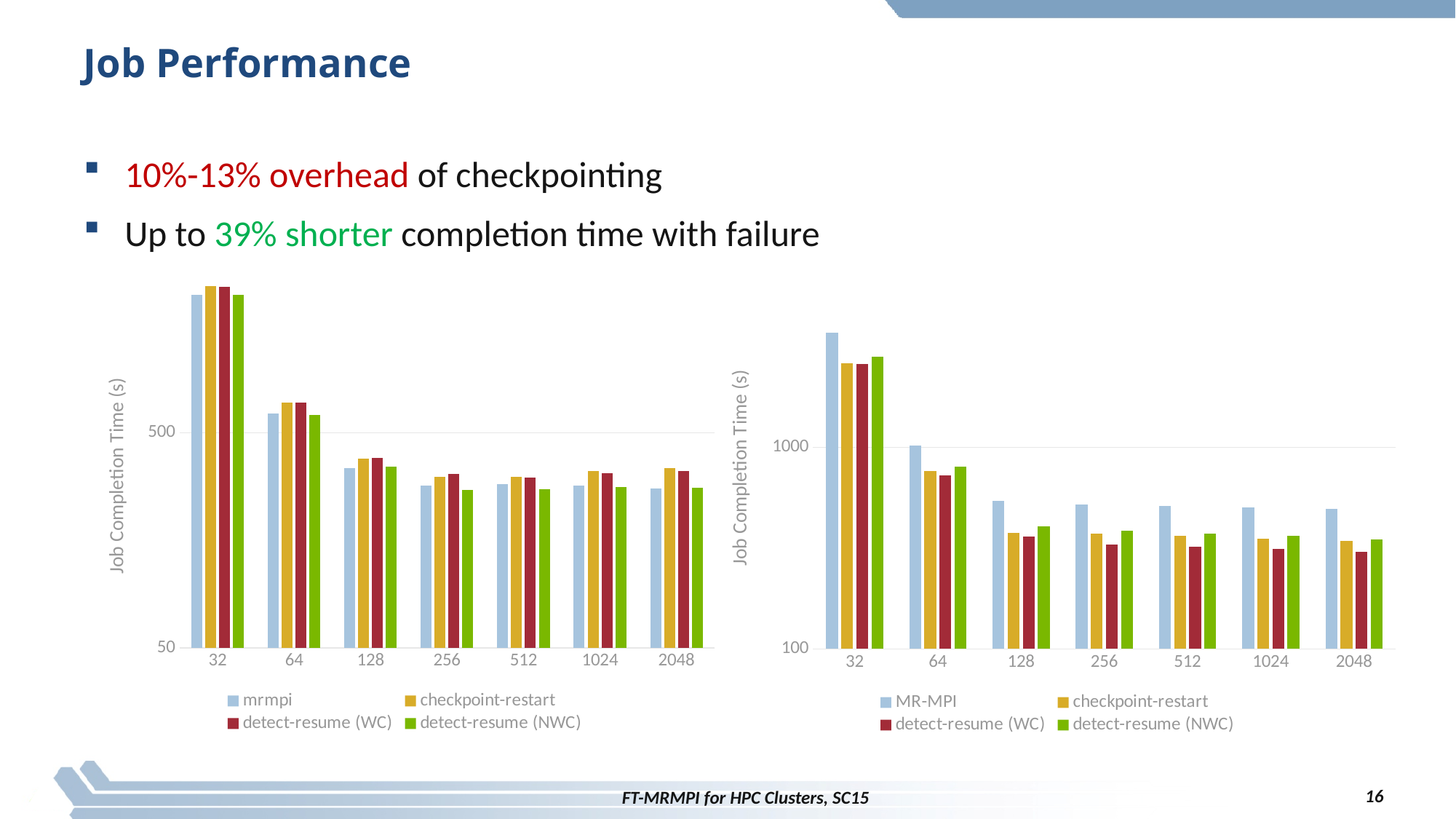
In the right chart, do the MR-MPI values rise or fall as the x axis goes from 32 to 2048? fall In the left chart, is the value for checkpoint-restart at 128 greater or less than 500? less What kind of chart is the left chart? bar chart In the right chart, is the value for detect-resume (WC) at 128 greater or less than 1000? less In the right chart, which category has the highest MR-MPI value? 32 How many categories are shown on the x axis of the right chart? 7 In the left chart, is the value for mrmpi at 32 greater or less than 500? greater What is the y-axis label of the left chart? Job Completion Time (s) How many series does the legend of the left chart list? 4 In the right chart, at 128, which is larger: MR-MPI or detect-resume (WC)? MR-MPI In the right chart, at 32, which is larger: MR-MPI or checkpoint-restart? MR-MPI